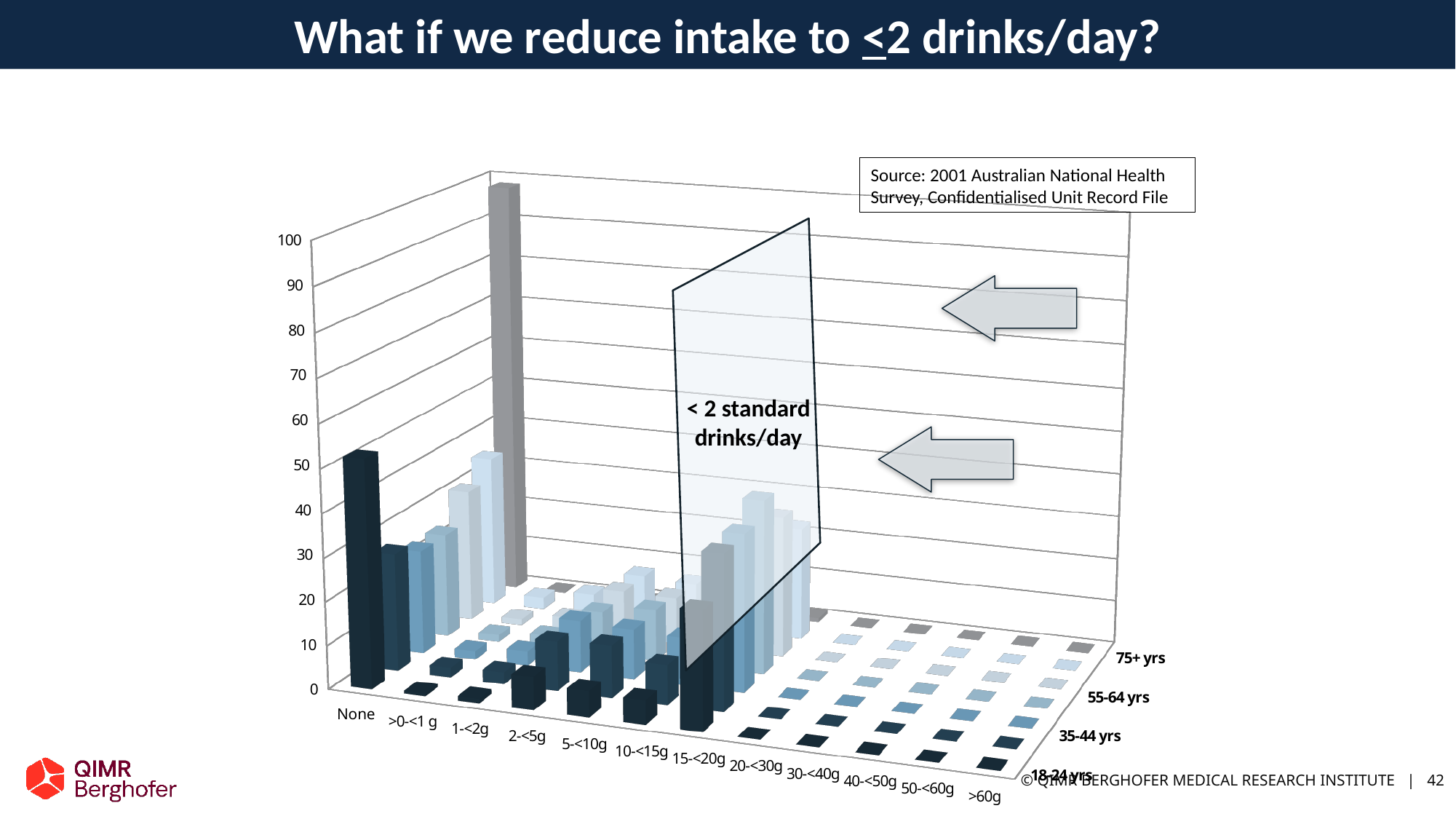
For the 18-24 yrs series, which is larger: the value for 2-<5g or the value for >0-<1 g? 2-<5g For the 18-24 yrs series, is the value for >60g greater or less than 10? less How many alcohol intake categories are shown along the x axis? 12 What is the last category on the x axis? >60g For the 18-24 yrs series, which intake category has the highest bar? None For the 18-24 yrs series, is the value for None greater or less than 40? greater For the 18-24 yrs series, is the value for None greater or less than 70? less What is the highest value shown on the vertical axis? 100 What kind of chart is shown on the slide? 3D bar chart What is the first category on the x axis? None For the 18-24 yrs series, which is larger: the value for None or the value for 15-<20g? None